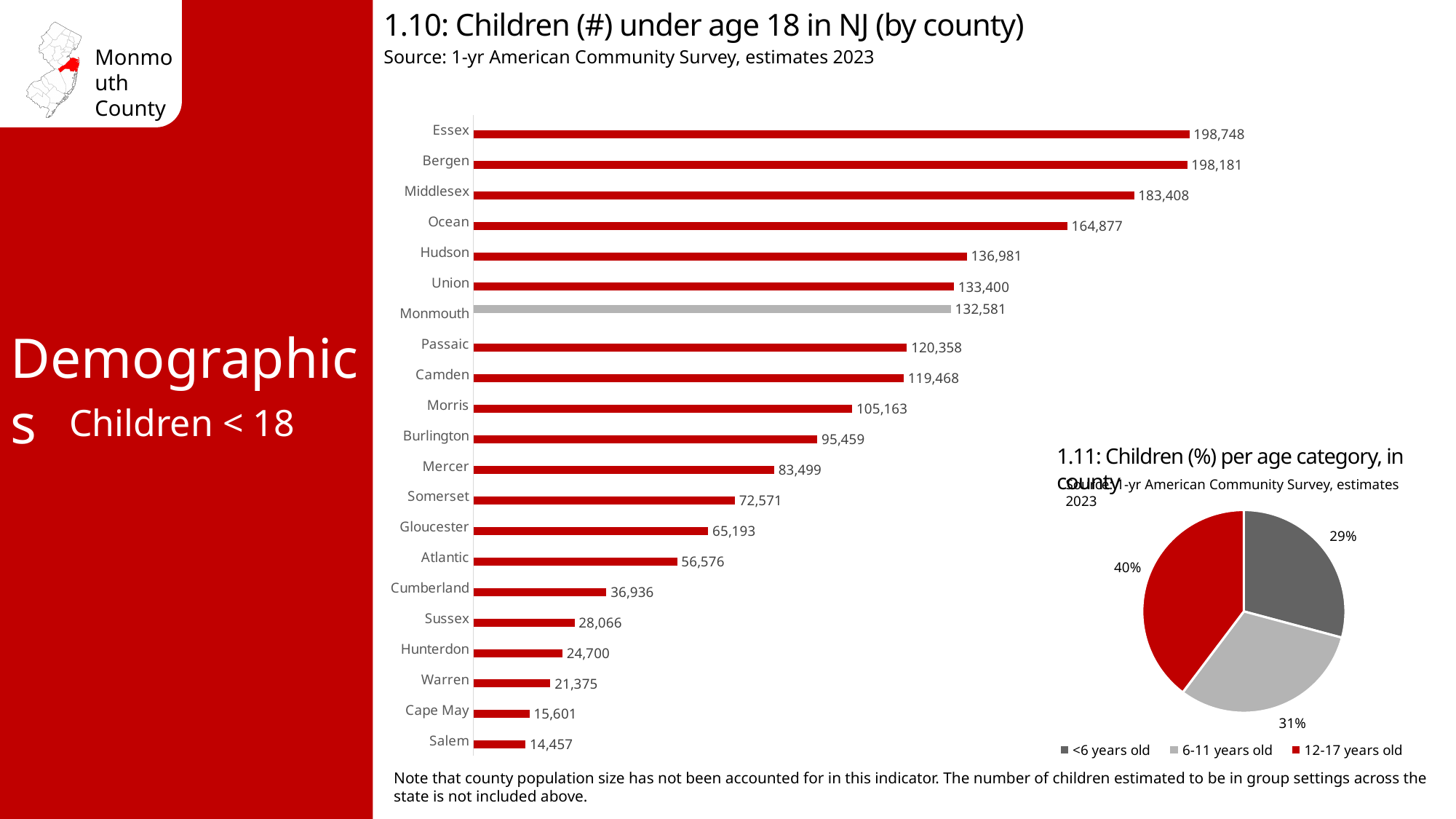
In the pie chart '1.11: Children (%) per age category, in county', which age category has the smallest share? <6 years old In the chart '1.10: Children (#) under age 18 in NJ (by county)', what is the value for Monmouth? 132,581 In the chart '1.10: Children (#) under age 18 in NJ (by county)', what is the value for Ocean? 164,877 What kind of chart is '1.10: Children (#) under age 18 in NJ (by county)'? Bar chart In the chart '1.10: Children (#) under age 18 in NJ (by county)', which has a larger value, Morris or Burlington? Morris In the pie chart '1.11: Children (%) per age category, in county', what share is 12-17 years old? 40% In the chart '1.10: Children (#) under age 18 in NJ (by county)', which county's bar is coloured grey instead of red? Monmouth In the chart '1.10: Children (#) under age 18 in NJ (by county)', what is the difference between the values for Ocean and Hudson? 27,896 How many age categories does the legend of the pie chart '1.11: Children (%) per age category, in county' list? 3 How many counties are shown in the chart '1.10: Children (#) under age 18 in NJ (by county)'? 21 In the chart '1.10: Children (#) under age 18 in NJ (by county)', which county has the lowest value? Salem In the chart '1.10: Children (#) under age 18 in NJ (by county)', what is the difference between the values for Union and Monmouth? 819